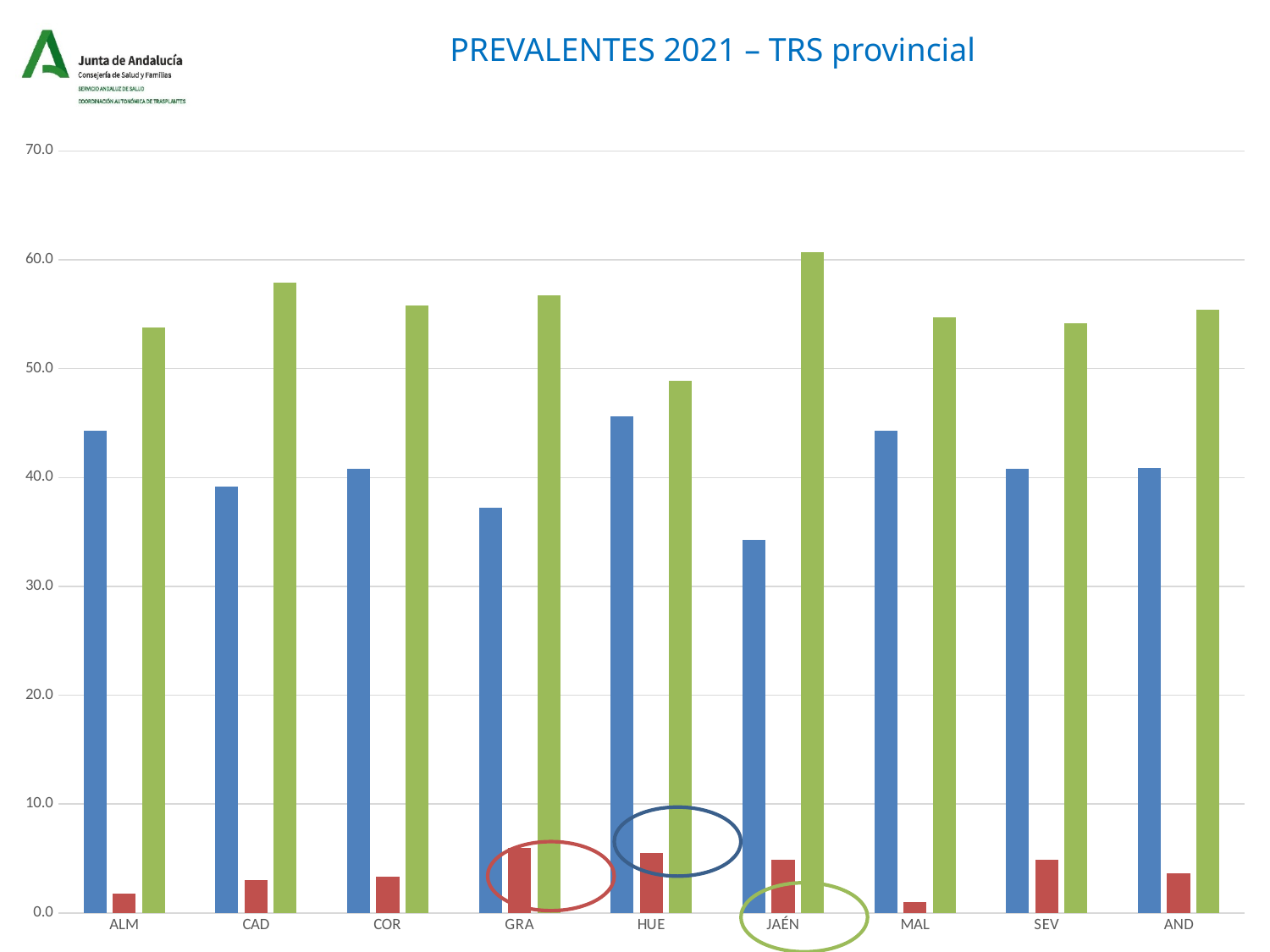
Which category has the tallest green bar? JAÉN Which category has the shortest red bar? MAL How many differently coloured bars are shown for each category? 3 How many categories are shown along the x axis? 9 Is the blue bar for JAÉN greater or less than 40? less What is the title of the chart? PREVALENTES 2021 – TRS provincial Which is larger, the blue bar for HUE or the blue bar for JAÉN? HUE What kind of chart is shown on the slide? bar chart Is the blue bar for HUE greater or less than 40? greater Which category has the shortest blue bar? JAÉN Is the green bar for HUE greater or less than 50? less Which category has the shortest green bar? HUE